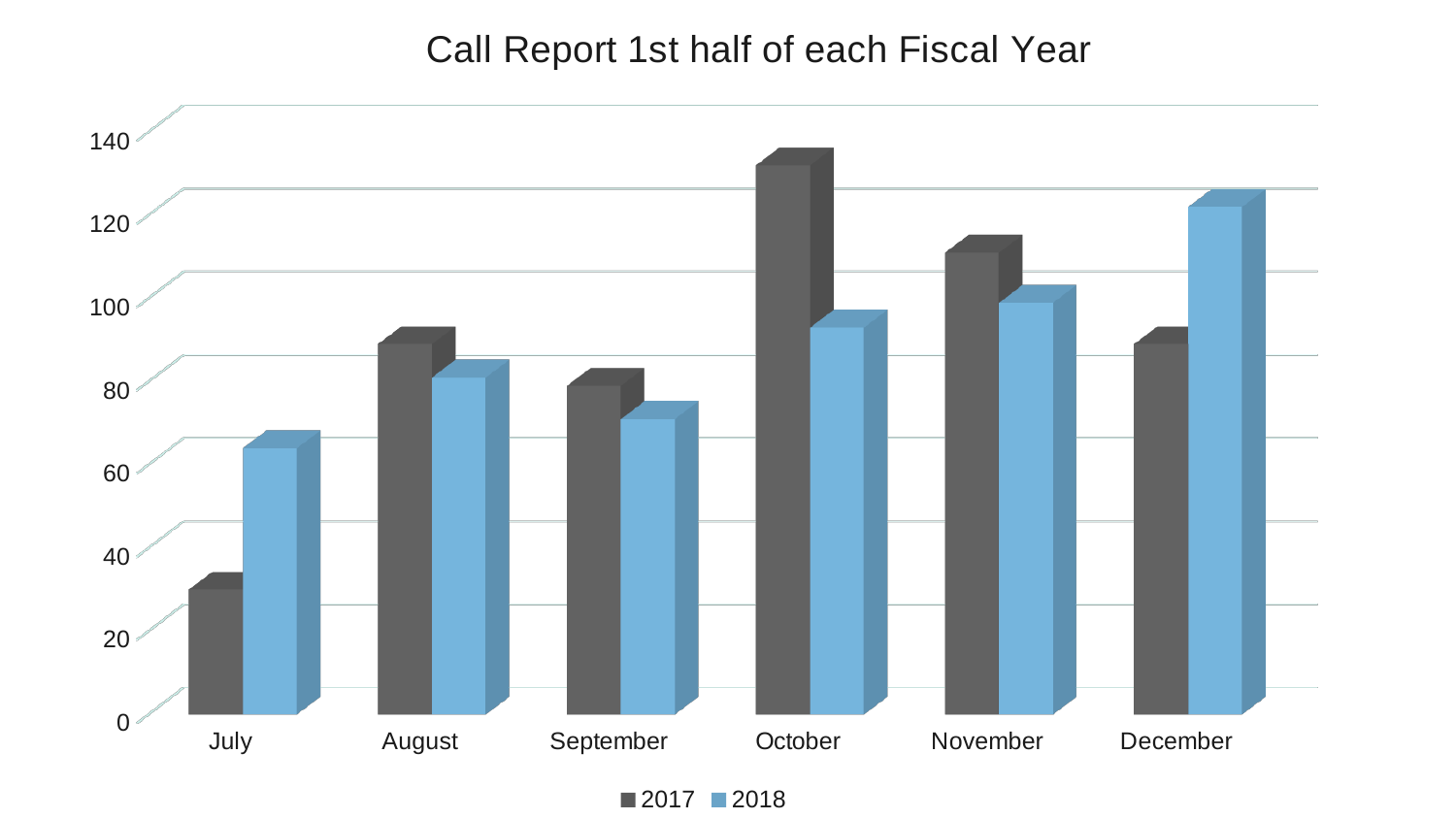
Which month has the highest value for 2018? December Which month has the highest value for 2017? October What is the title of the chart? Call Report 1st half of each Fiscal Year What kind of chart is shown on the slide? bar chart Is the value for 2017 in October greater or less than 120? greater Which month has the lowest value for 2017? July Which month has the lowest value for 2018? July In July, which series has the larger value, 2017 or 2018? 2018 In October, which series has the larger value, 2017 or 2018? 2017 How many series does the legend list? 2 Is the value for 2017 in July greater or less than 40? less How many months are shown on the x axis? 6